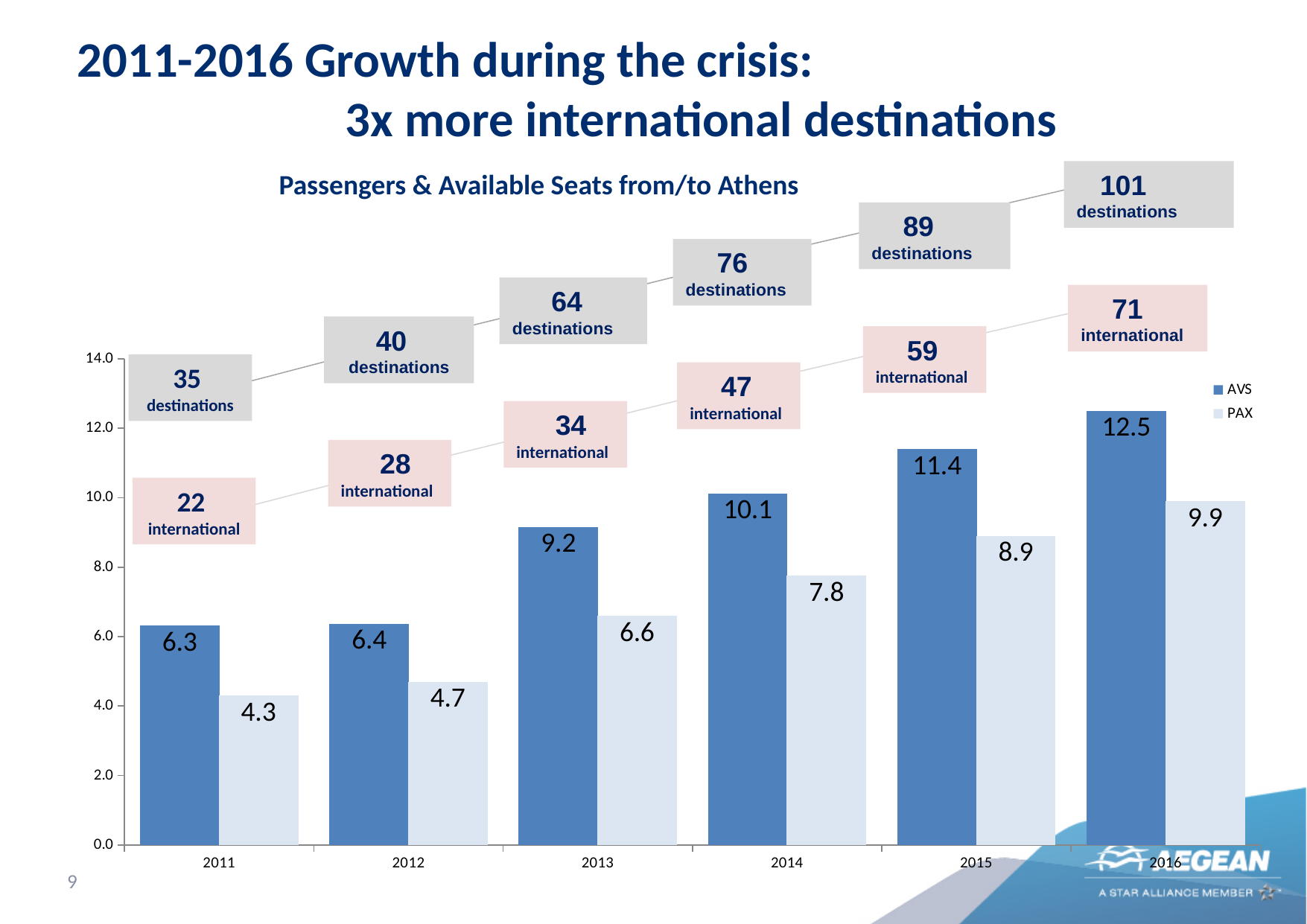
What kind of chart is shown? Bar chart What is the title of the chart? Passengers & Available Seats from/to Athens Which year has the lowest PAX value? 2011 Which year has the highest AVS value? 2016 Do the PAX values rise or fall from 2011 to 2016? Rise What is the PAX value for 2011? 4.3 Which is larger, the AVS value for 2012 or the PAX value for 2014? PAX value for 2014 What is the PAX value for 2013? 6.6 How many series does the legend list? 2 What is the difference between the AVS and PAX values in 2015? 2.5 How many years are shown on the x axis? 6 What is the AVS value for 2016? 12.5